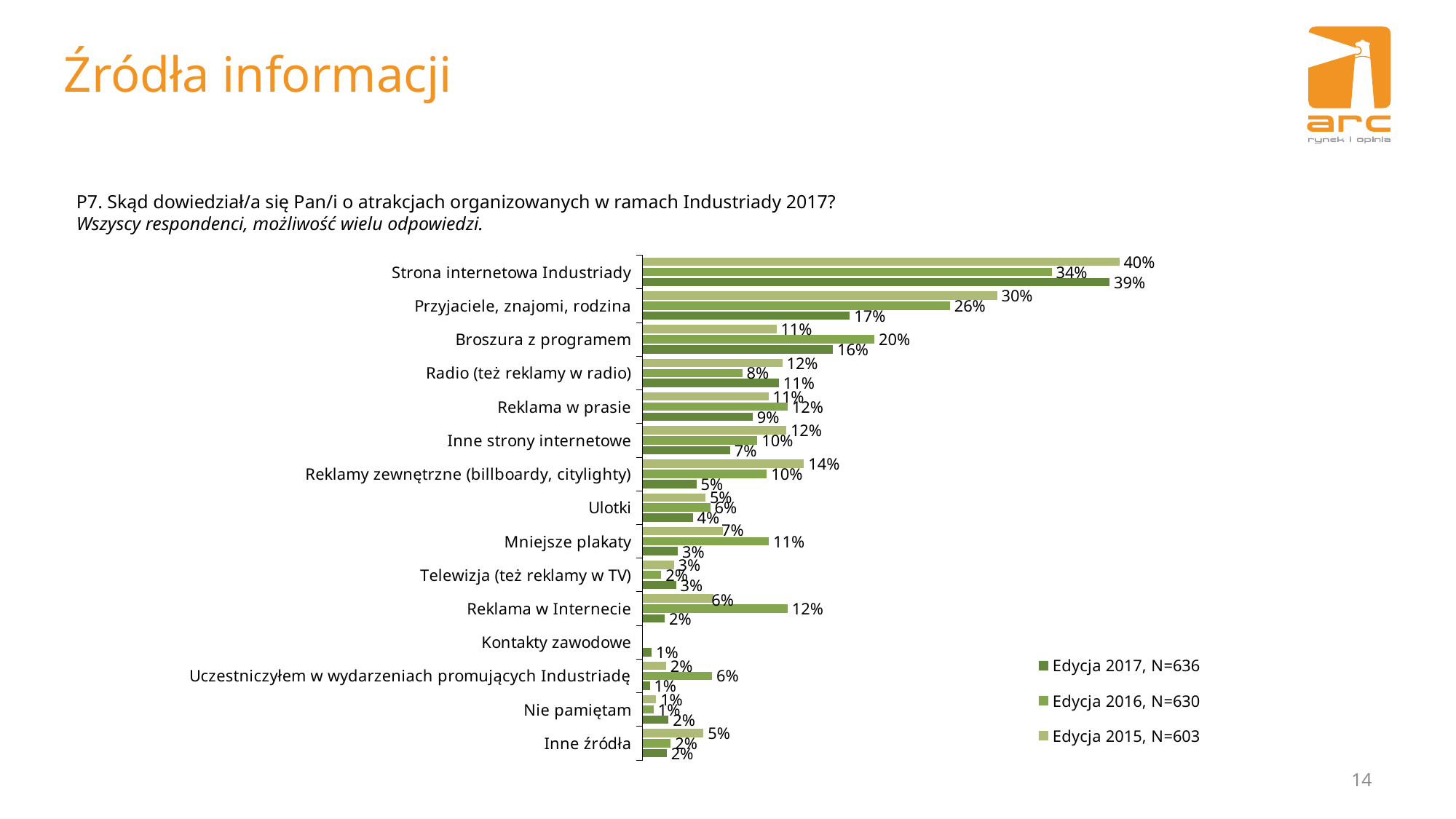
Which category has the highest value in Edycja 2017? Strona internetowa Industriady For 'Reklama w Internecie', which edition has the larger value, Edycja 2016 or Edycja 2017? Edycja 2016 What kind of chart is shown on the slide? bar chart What is the value for 'Kontakty zawodowe' in Edycja 2017? 1% What is the value for 'Mniejsze plakaty' in Edycja 2017? 3% How many series does the legend list? 3 What is the value for 'Reklamy zewnętrzne (billboardy, citylighty)' in Edycja 2015? 14% What is the difference between the Edycja 2015 and Edycja 2017 values for 'Przyjaciele, znajomi, rodzina'? 13% What sample size (N) is given in the legend for Edycja 2015? N=603 How many categories (information sources) are shown on the chart? 15 What is the value for 'Strona internetowa Industriady' in Edycja 2017? 39% What is the value for 'Broszura z programem' in Edycja 2016? 20%